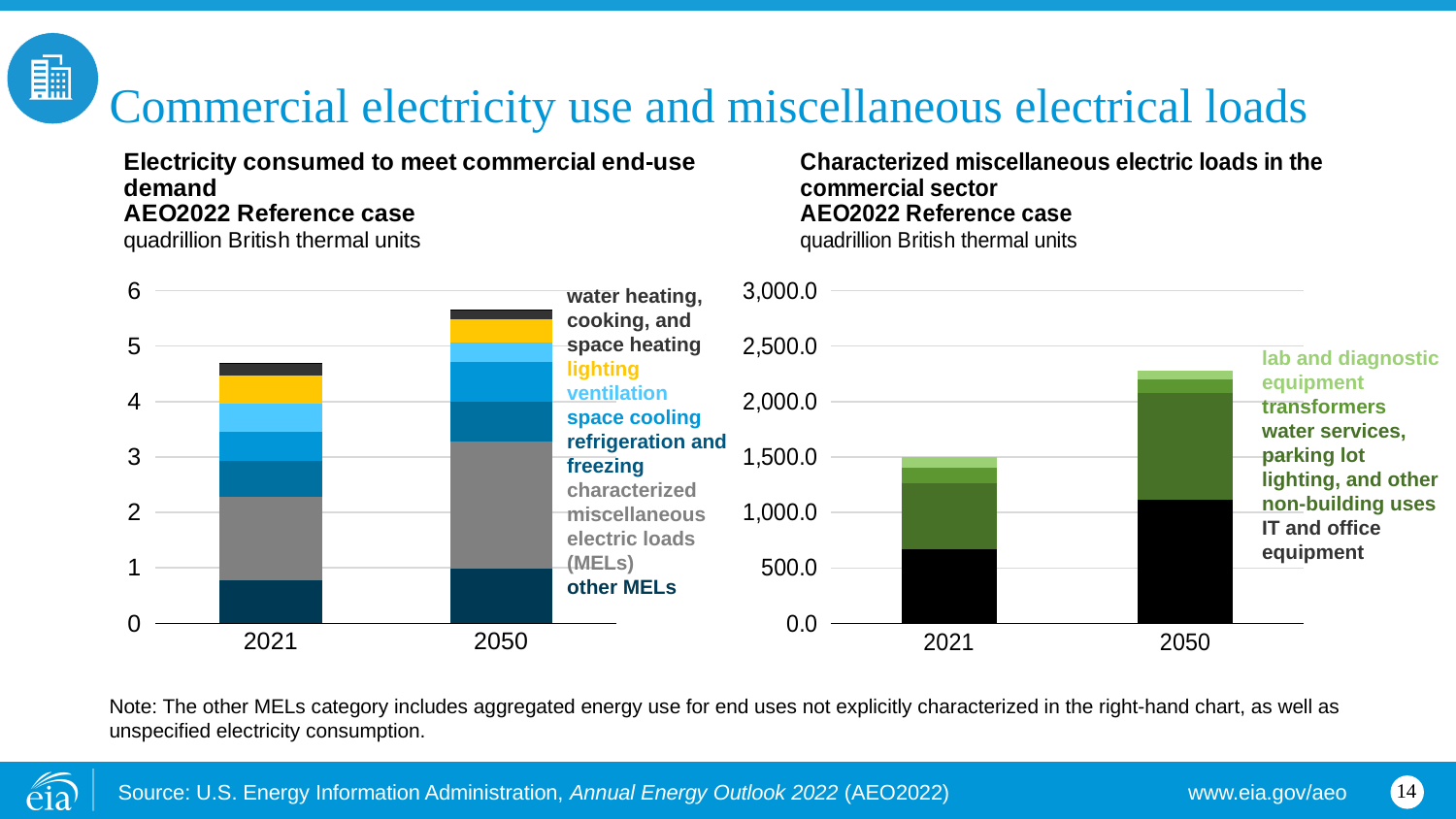
In the left-hand chart, how many years are shown on the x axis? 2 In the left-hand chart, is the total electricity consumed in 2021 greater or less than 5? less In the left-hand chart, is the total electricity consumed in 2050 greater or less than 5? greater What kind of chart is the right-hand chart, 'Characterized miscellaneous electric loads in the commercial sector'? stacked bar chart In the right-hand chart, how many series are listed in the legend? 4 In the left-hand chart, does total commercial electricity use rise or fall from 2021 to 2050? rise In the right-hand chart, is the total for 2050 greater or less than 2,000.0? greater What kind of chart is the left-hand chart, 'Electricity consumed to meet commercial end-use demand'? stacked bar chart In the right-hand chart, which year has the larger total, 2021 or 2050? 2050 What unit is used on the y axis of both charts? quadrillion British thermal units In the left-hand chart, how many series are listed in the legend? 7